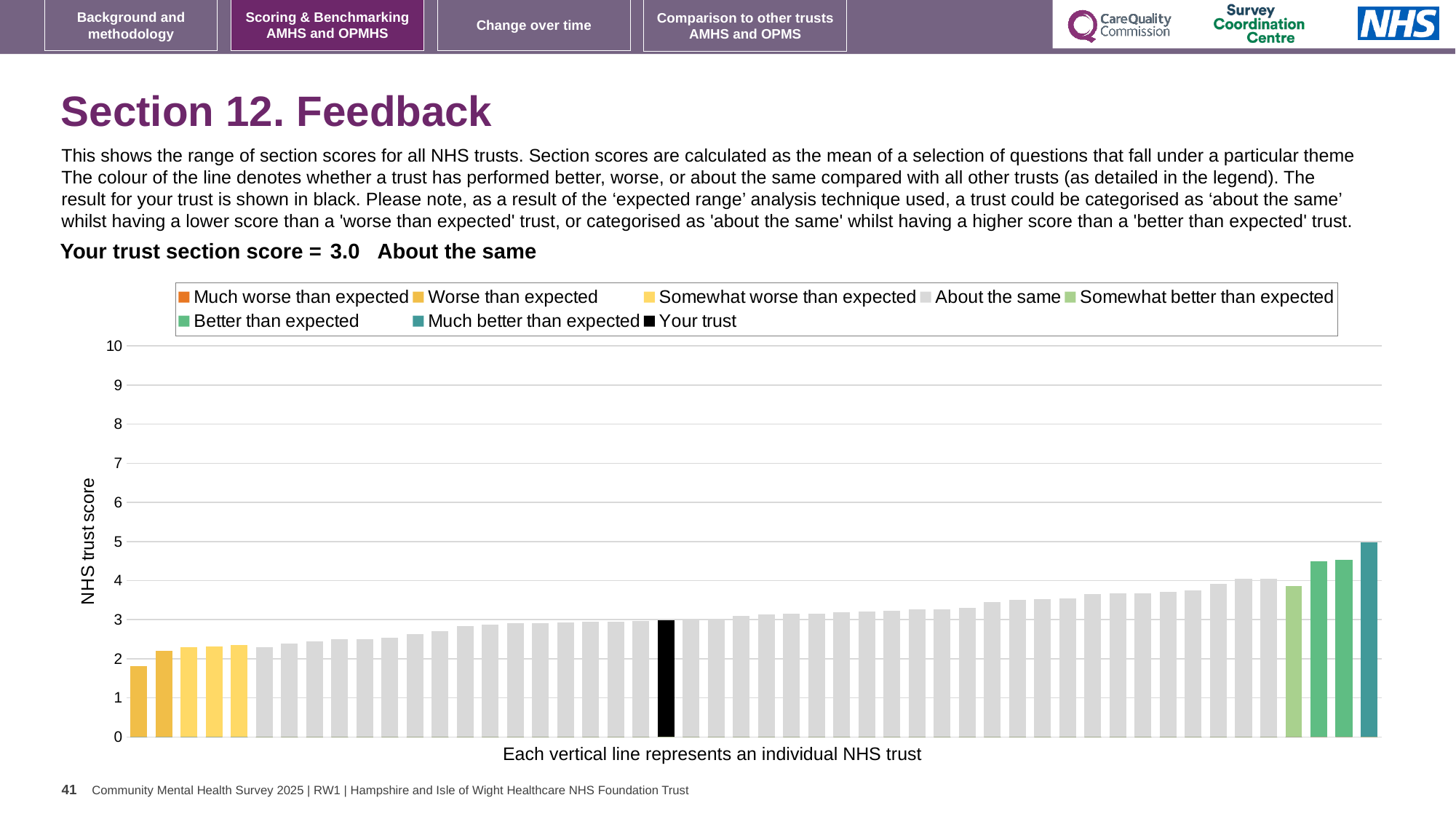
What colour is used for the 'Your trust' bar in the chart? black Is the value for your trust greater or less than 2? greater How many entries does the chart legend list? 8 What is the section score for your trust shown on the slide? 3.0 Is the value of the shortest bar in the chart greater or less than 3? less Is the value of the tallest bar in the chart greater or less than 4? greater Which legend category does the tallest bar in the chart belong to? Much better than expected What kind of chart is shown on the slide? bar chart Do the bar values rise or fall moving from left to right along the x axis? rise How many bars are coloured as 'Better than expected' (green)? 2 Which performance category is your trust placed in for Section 12. Feedback? About the same What is the label on the vertical axis of the chart? NHS trust score